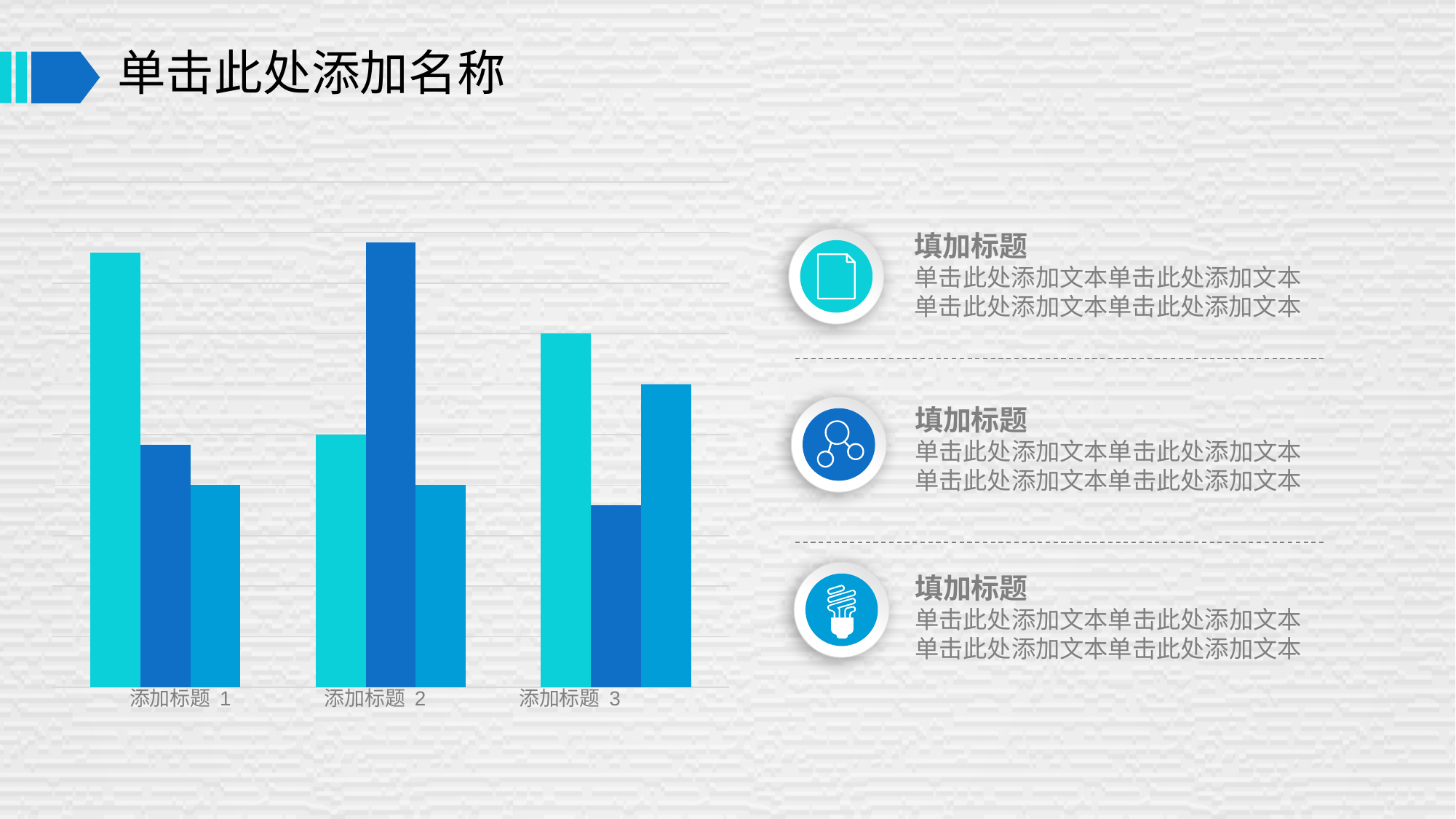
In the category 添加标题 1, which of the three bars is the tallest? the teal (first) bar Which category has the tallest teal (first) bar? 添加标题 1 In the category 添加标题 2, which of the three bars is the tallest? the dark blue (middle) bar How many categories are shown along the x axis of the bar chart? 3 Which category has the shortest dark blue (middle) bar? 添加标题 3 In the category 添加标题 3, which of the three bars is the shortest? the dark blue (middle) bar Is the teal (first) bar taller for 添加标题 1 or for 添加标题 2? 添加标题 1 How many bars are plotted for each category in the bar chart? 3 What is the label of the first category on the x axis of the bar chart? 添加标题 1 What kind of chart is shown on the left of the slide? bar chart